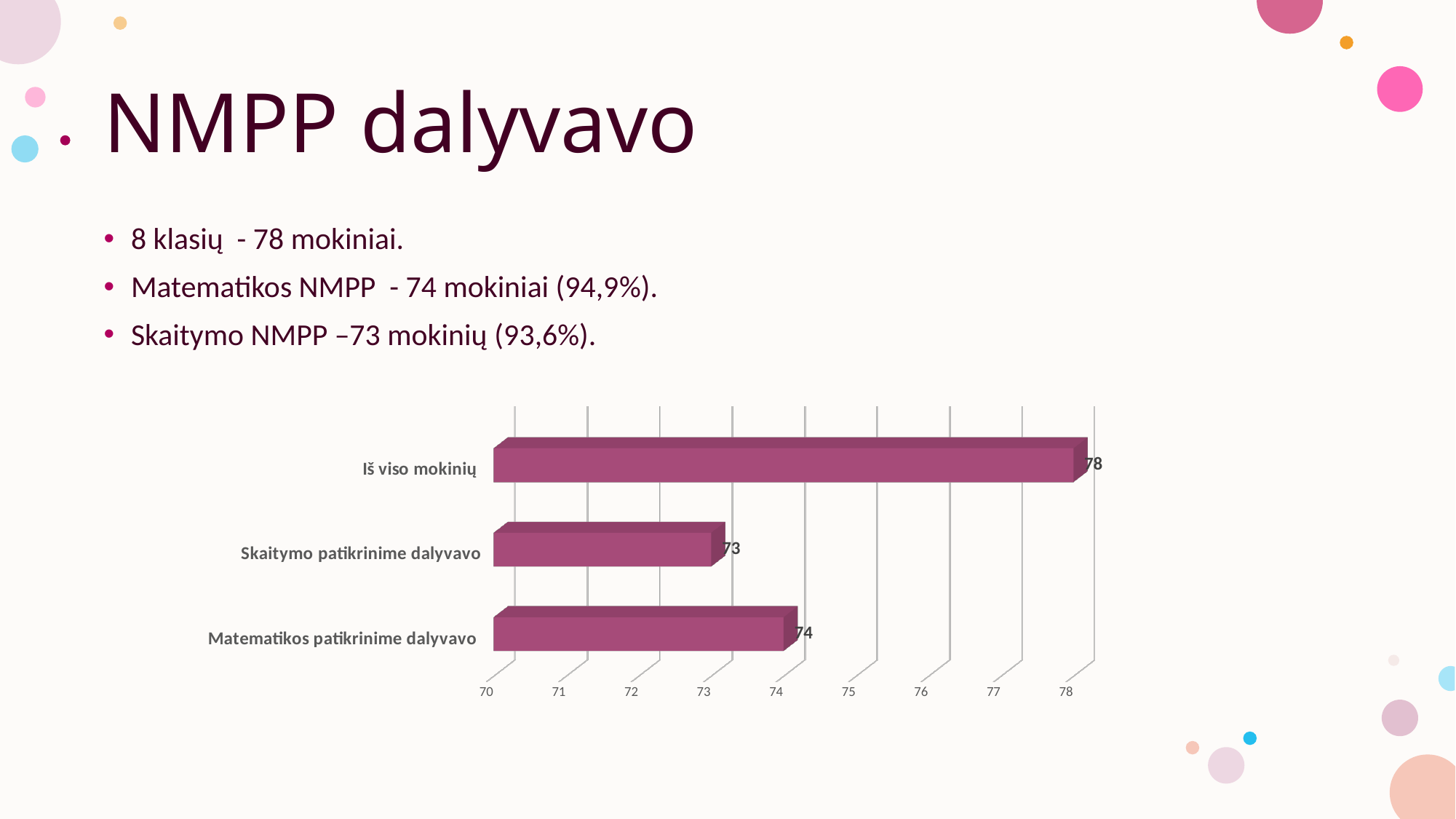
What is the value for "Iš viso mokinių"? 78 What is the difference between "Matematikos patikrinime dalyvavo" and "Skaitymo patikrinime dalyvavo"? 1 Which category has the lowest value? Skaitymo patikrinime dalyvavo What is the value for "Skaitymo patikrinime dalyvavo"? 73 What is the value for "Matematikos patikrinime dalyvavo"? 74 What is the lowest value shown on the chart's value axis? 70 What is the difference between "Iš viso mokinių" and "Skaitymo patikrinime dalyvavo"? 5 What kind of chart is shown on the slide? bar chart How many categories are shown in the chart? 3 Is the value for "Skaitymo patikrinime dalyvavo" greater or less than 75? less Which category has the highest value? Iš viso mokinių Which is larger: the value for "Matematikos patikrinime dalyvavo" or "Skaitymo patikrinime dalyvavo"? Matematikos patikrinime dalyvavo